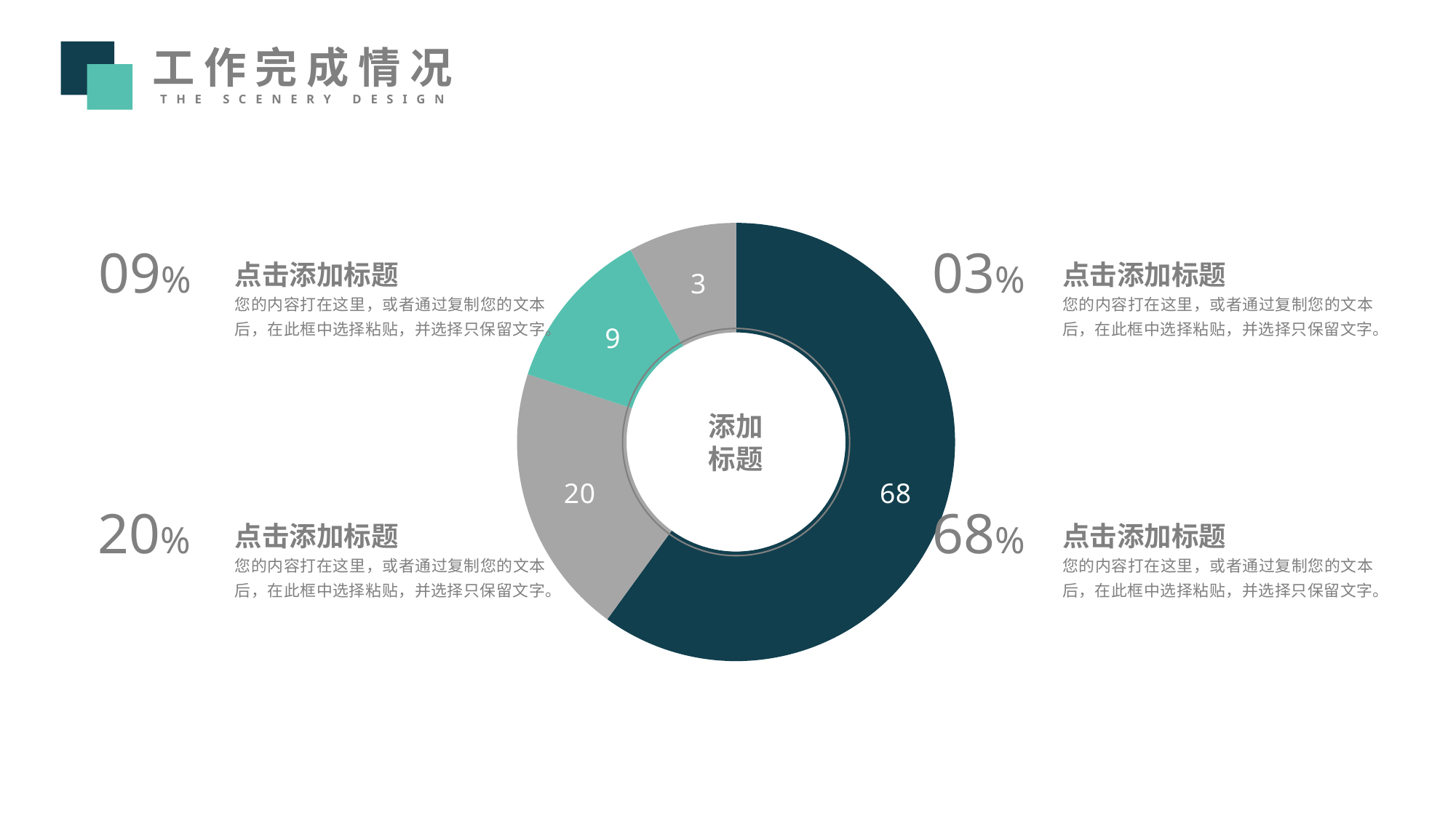
What is the value of the small gray slice at the top of the donut chart? 3 What is the total of all four slice values in the donut chart? 100 What is the value of the gray slice on the left side of the donut chart? 20 Which slice of the donut chart has the smallest value? The small gray slice at the top (3) What is the difference between the dark teal slice (68) and the left gray slice (20)? 48 Which is larger, the green slice or the small gray slice at the top? The green slice How many slices does the donut chart have? 4 What share of the total does the dark teal slice represent? 68% What is the value of the dark teal slice in the donut chart? 68 What is the value of the green slice in the donut chart? 9 Which slice of the donut chart has the largest value? The dark teal slice (68) What kind of chart is shown on the slide? Donut (pie) chart